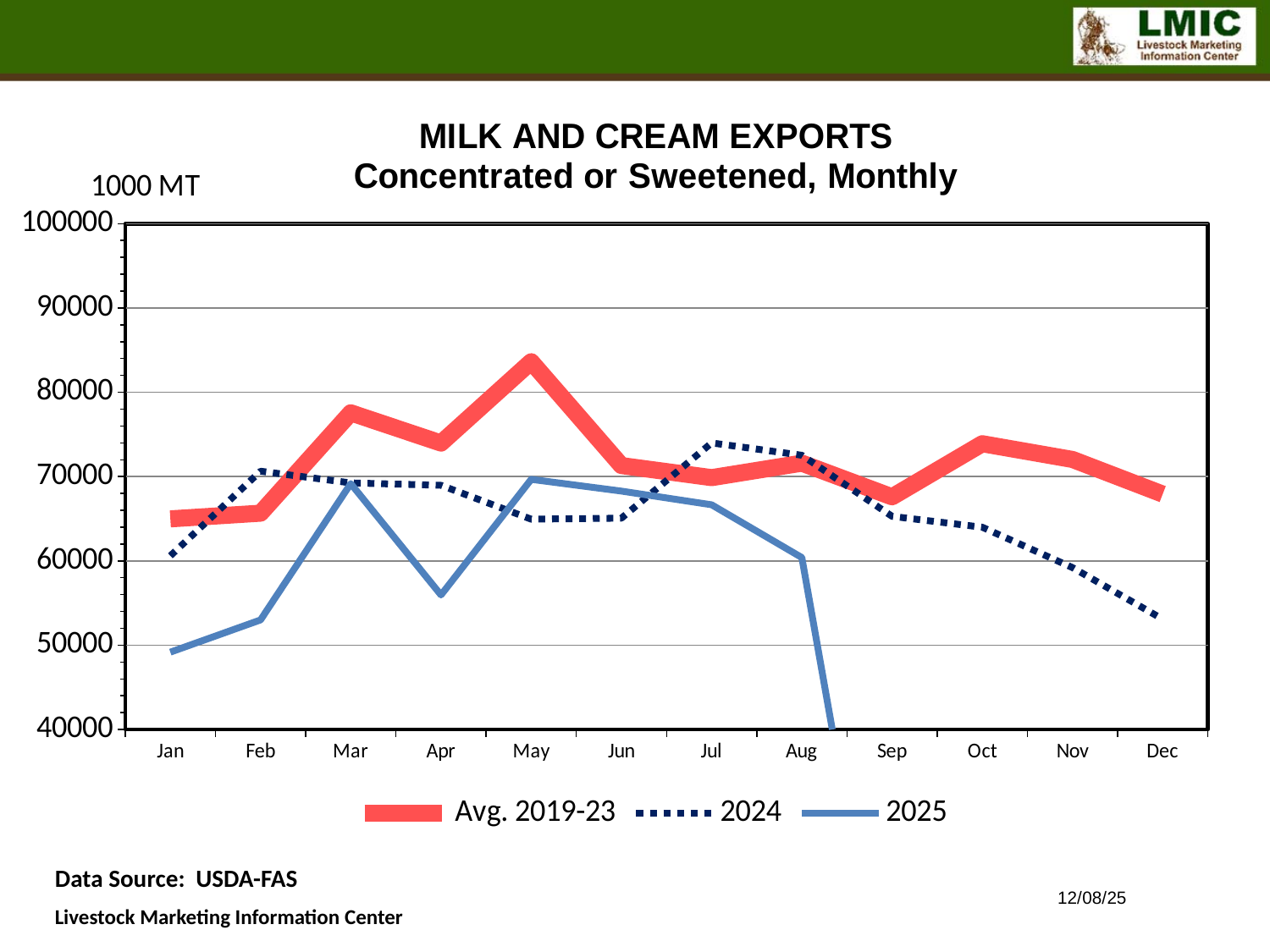
Is the value for 2024 in Dec greater or less than 60000? less Is the value for 2025 in Apr greater or less than 60000? less How many months are shown along the x axis? 12 How many series does the legend list? 3 In Jul, which series has the higher value, 2024 or Avg. 2019-23? 2024 Does the 2024 series rise or fall from Aug to Dec? fall In which month does the 2024 series reach its lowest value? Dec What is the title of the chart? MILK AND CREAM EXPORTS Concentrated or Sweetened, Monthly In Mar, which series has the higher value, Avg. 2019-23 or 2025? Avg. 2019-23 In which month does the Avg. 2019-23 series reach its highest value? May Is the value for Avg. 2019-23 in May greater or less than 80000? greater What kind of chart is shown on the slide? line chart